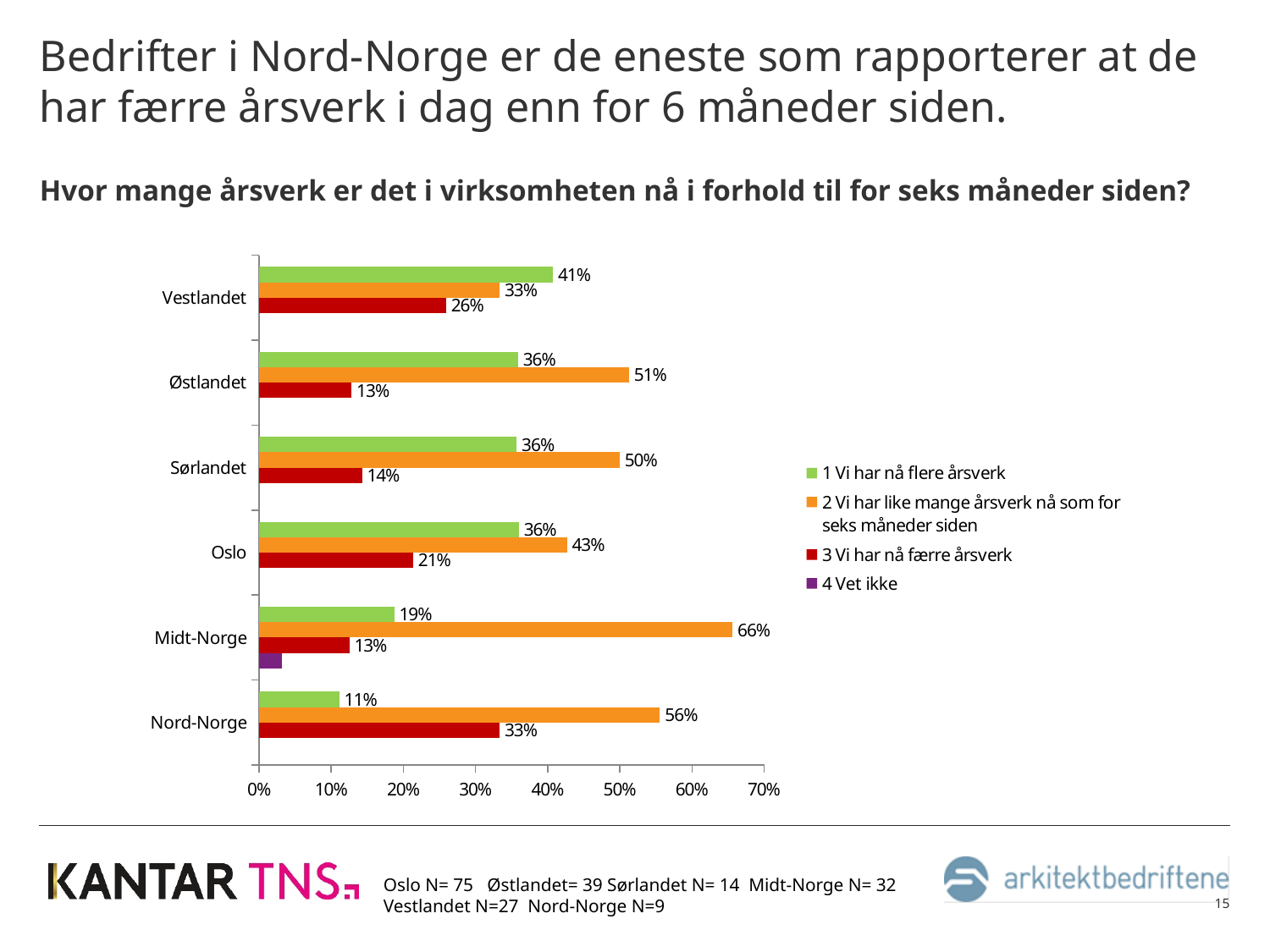
Which is larger: the '3 Vi har nå færre årsverk' value for Oslo or for Østlandet? Oslo Which region has the lowest value in the series '1 Vi har nå flere årsverk'? Nord-Norge Which region has the highest value in the series '1 Vi har nå flere årsverk'? Vestlandet How many regions are shown on the vertical axis? 6 What is the value for Vestlandet in the series '1 Vi har nå flere årsverk'? 41% Is the '2 Vi har like mange årsverk nå som for seks måneder siden' value for Nord-Norge greater or less than 50%? greater What kind of chart is shown on the slide? bar chart What is the difference between the '2 Vi har like mange årsverk nå som for seks måneder siden' value for Midt-Norge and for Oslo? 23% What is the value for Midt-Norge in the series '2 Vi har like mange årsverk nå som for seks måneder siden'? 66% What is the value for Nord-Norge in the series '3 Vi har nå færre årsverk'? 33% How many series does the legend list? 4 Which region is the only one with a visible bar for the series '4 Vet ikke'? Midt-Norge